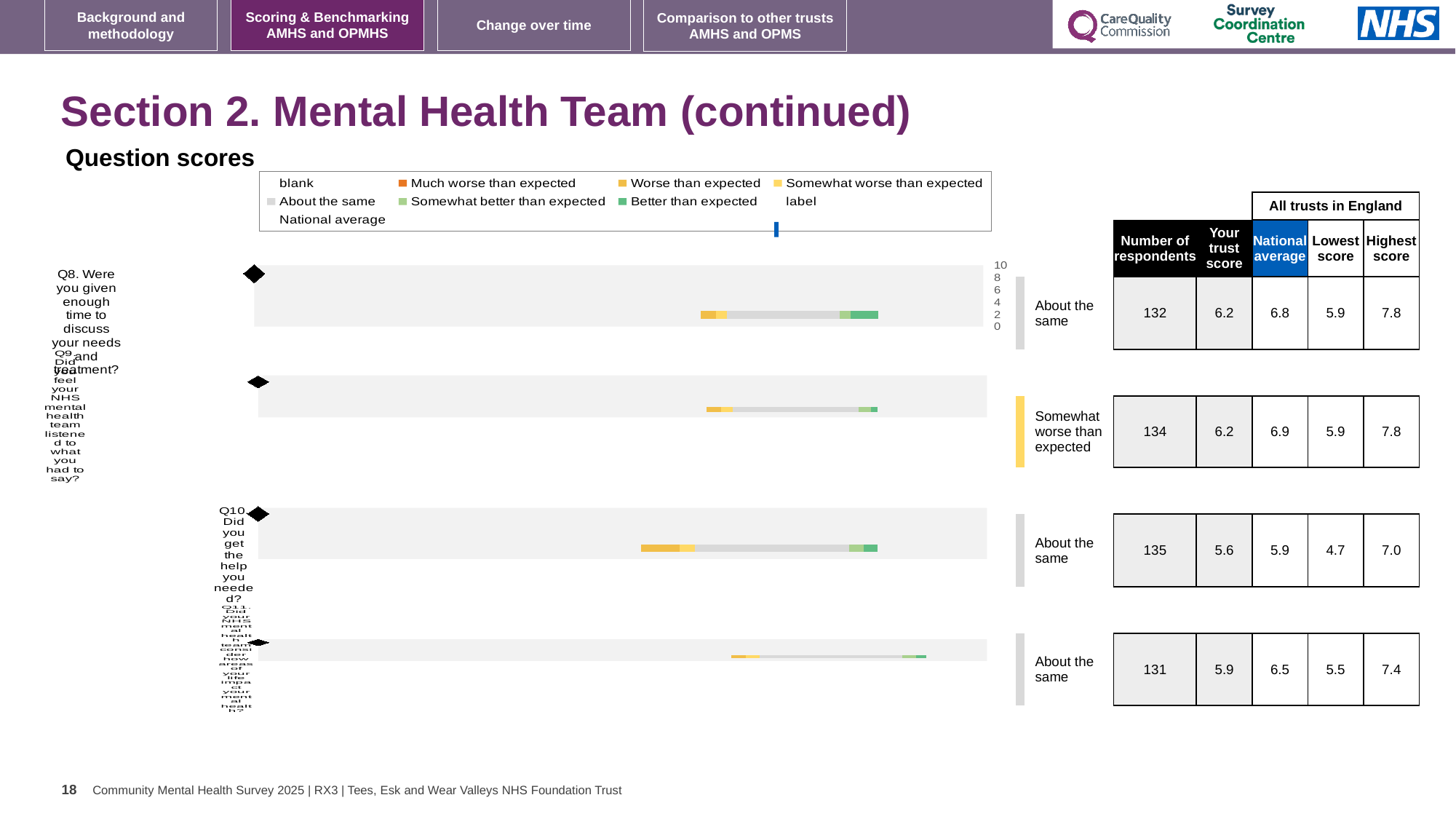
What kind of chart is used to show the question scores for Q8 to Q11? bar chart In the table beside the charts, what is the difference between the national average and 'Your trust score' for Q8? 0.6 In the table beside the charts, what is 'Your trust score' for Q10? 5.6 Which benchmark category is shown next to the bar for Q8? About the same In the table beside the charts, which question has the highest number of respondents? Q10 Which benchmark category is shown next to the bar for Q9? Somewhat worse than expected In the table beside the charts, what is the number of respondents for Q8? 132 How many questions (bars) are plotted in the question scores charts? 4 How many entries does the legend above the question scores charts list? 9 In the table beside the charts, what is the national average for Q11? 6.5 In the table beside the charts, which question has the lowest 'Your trust score'? Q10